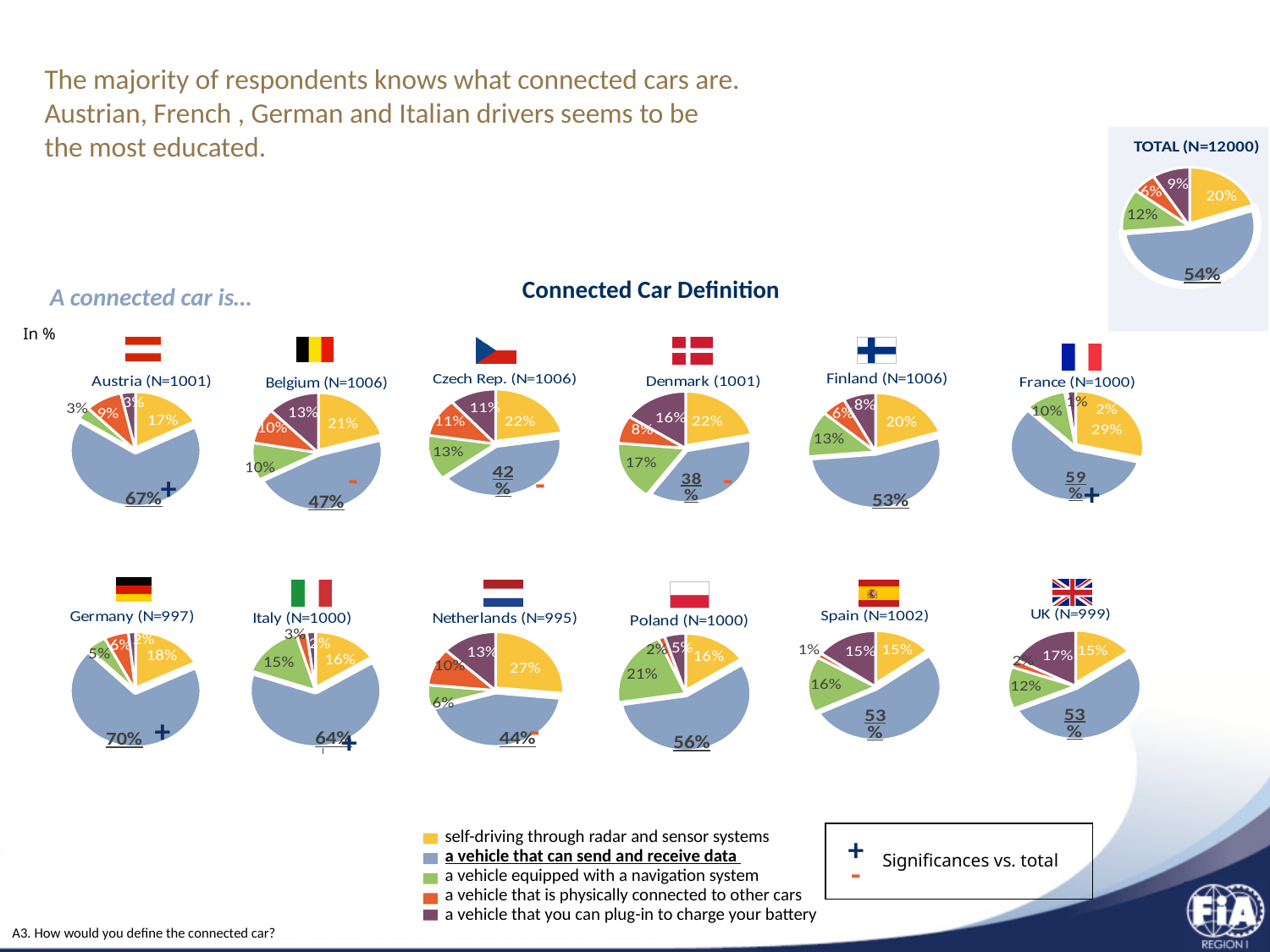
Across the country pie charts, which country has the lowest share for 'a vehicle that can send and receive data'? Denmark In the Denmark (1001) pie chart, what share chose 'a vehicle equipped with a navigation system'? 17% In the TOTAL (N=12000) pie chart, what share of respondents define a connected car as a vehicle that can send and receive data? 54% Across the country pie charts, which country has the highest share for 'a vehicle that can send and receive data'? Germany What is the difference in percentage points between Germany's and Denmark's shares for 'a vehicle that can send and receive data'? 32 percentage points In the TOTAL (N=12000) pie chart, what share chose 'self-driving through radar and sensor systems'? 20% Which has a larger share for 'a vehicle that can send and receive data': Austria or Belgium? Austria In the France (N=1000) pie chart, what share chose 'self-driving through radar and sensor systems'? 29% How many country pie charts are shown on the slide, excluding the TOTAL chart? 12 In the Germany (N=997) pie chart, what share chose 'a vehicle that can send and receive data'? 70% How many entries does the legend list? 5 What kind of charts are used on this slide? Pie charts